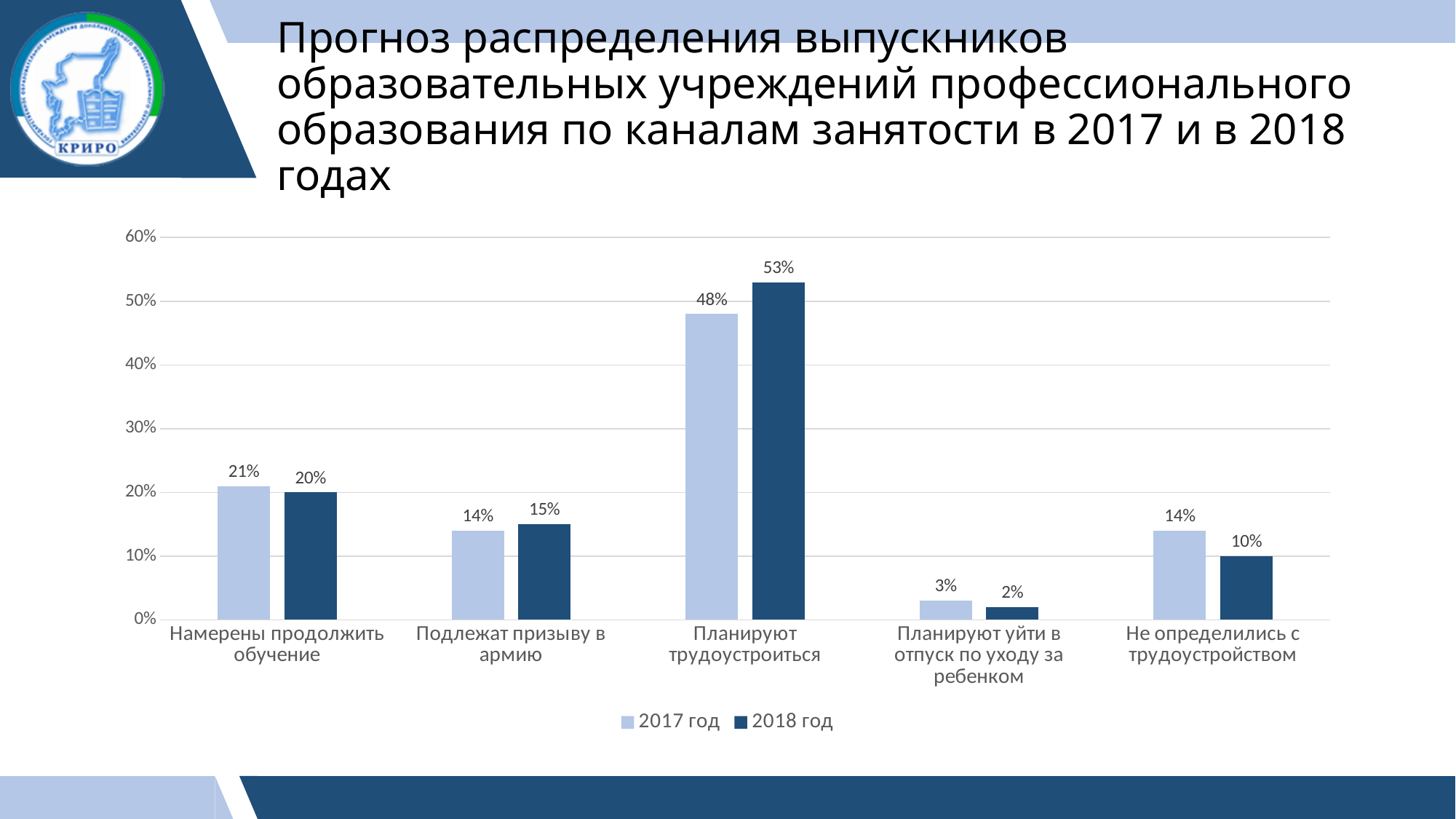
What is the value for "Не определились с трудоустройством" in the 2018 год series? 10% What is the value for "Намерены продолжить обучение" in the 2017 год series? 21% Which is larger for "Не определились с трудоустройством": the 2017 год value or the 2018 год value? 2017 год What kind of chart is shown on the slide? bar chart How many series does the legend list? 2 Is the 2017 год value for "Планируют трудоустроиться" greater or less than 40%? greater What is the value for "Планируют трудоустроиться" in the 2018 год series? 53% How many categories are shown on the x axis? 5 Which category has the highest value in the 2017 год series? Планируют трудоустроиться What is the difference between the 2018 год and 2017 год values for "Планируют трудоустроиться"? 5% Which series is shown in the darker blue colour? 2018 год Which category has the lowest value in the 2018 год series? Планируют уйти в отпуск по уходу за ребенком